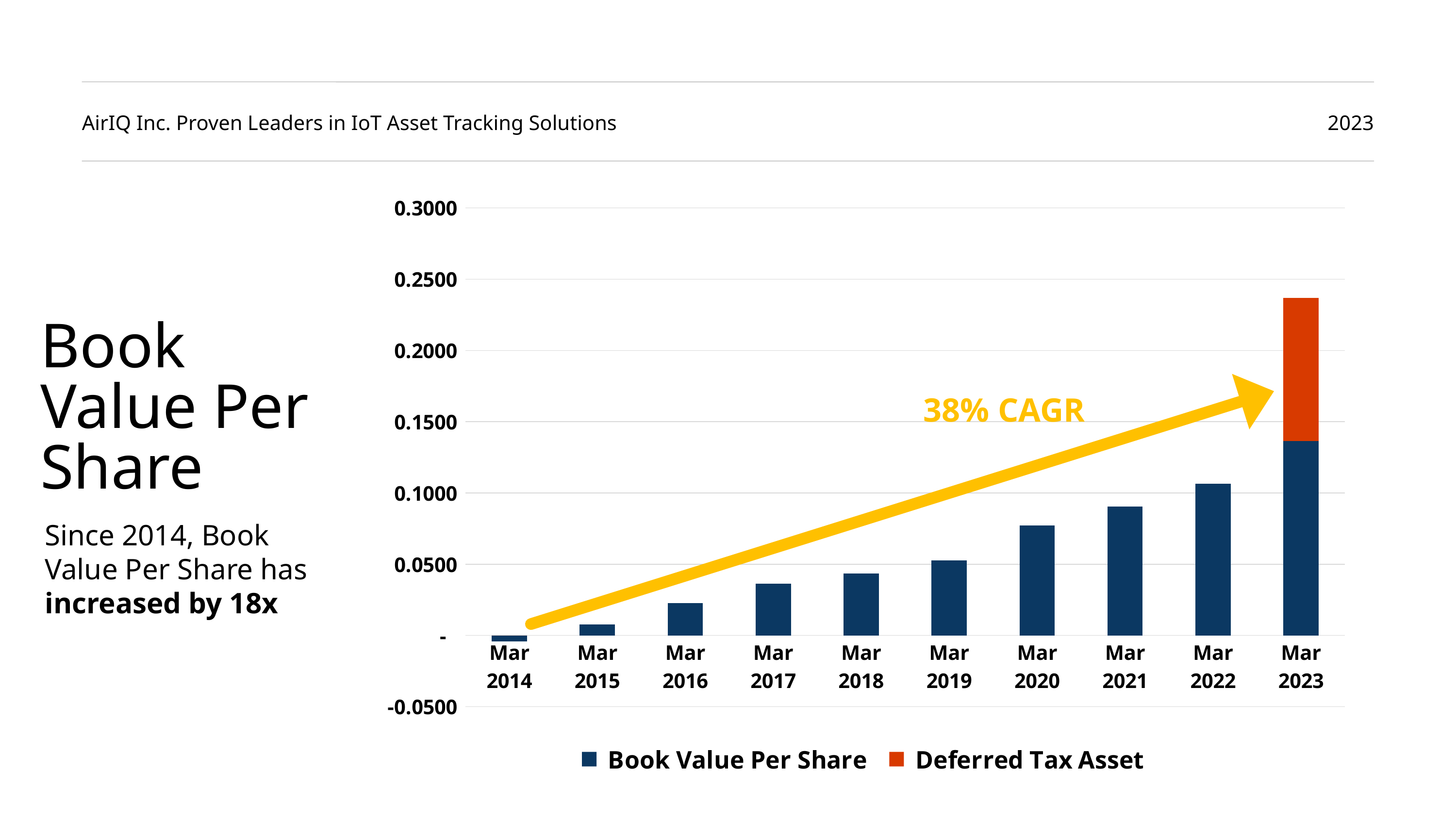
Is the Book Value Per Share for Mar 2020 greater or less than 0.1000? less Is the total height of the Mar 2023 bar greater or less than 0.2000? greater Is the Book Value Per Share for Mar 2017 greater or less than 0.0500? less Which year is the only one with a Deferred Tax Asset segment? Mar 2023 What kind of chart is shown on the slide? Stacked bar chart Do the Book Value Per Share bars rise or fall from Mar 2014 to Mar 2023? Rise How many years (categories) are plotted along the x axis? 10 How many series does the legend list? 2 Which is larger, the Book Value Per Share for Mar 2020 or for Mar 2016? Mar 2020 Which year has the lowest Book Value Per Share? Mar 2014 Which year has the tallest bar? Mar 2023 What CAGR is annotated on the chart? 38% CAGR